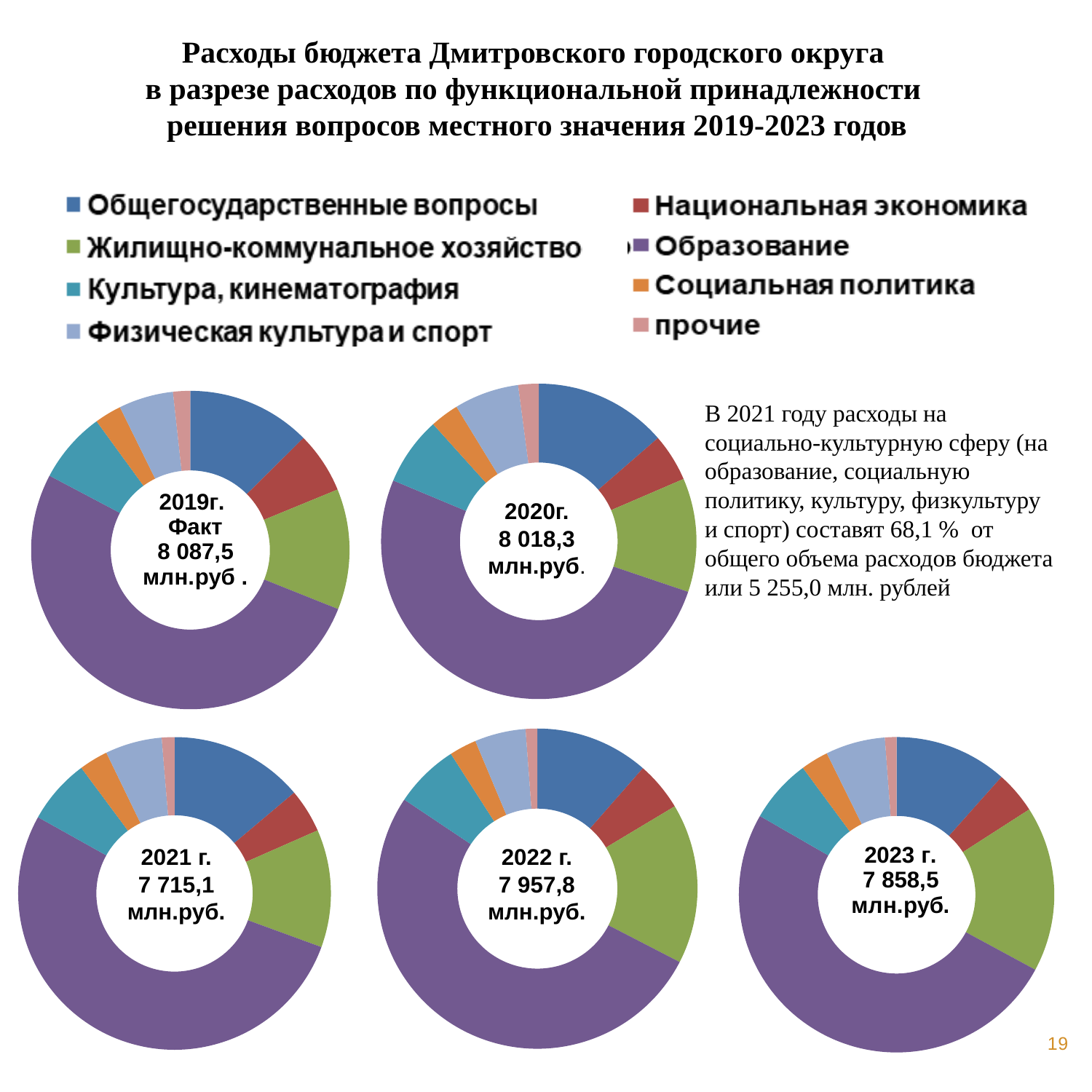
Which year's chart shows the highest total budget expenditure? 2019 In the 2023 chart, which slice is larger: Жилищно-коммунальное хозяйство or Национальная экономика? Жилищно-коммунальное хозяйство How many categories does the legend list? 8 What total is printed in the centre of the 2021 chart? 7 715,1 млн.руб. How many charts are shown on the slide? 5 In the 2021 chart, which category has the largest slice? Образование What is the difference between the totals printed on the 2022 and 2021 charts? 242,7 млн.руб. Which year's chart shows the lowest total budget expenditure? 2021 What is the difference between the totals printed on the 2019 and 2020 charts? 69,2 млн.руб. What total is printed in the centre of the 2019 chart? 8 087,5 млн.руб. Which is larger, the total on the 2022 chart or the total on the 2023 chart? 2022 What total is printed in the centre of the 2023 chart? 7 858,5 млн.руб.